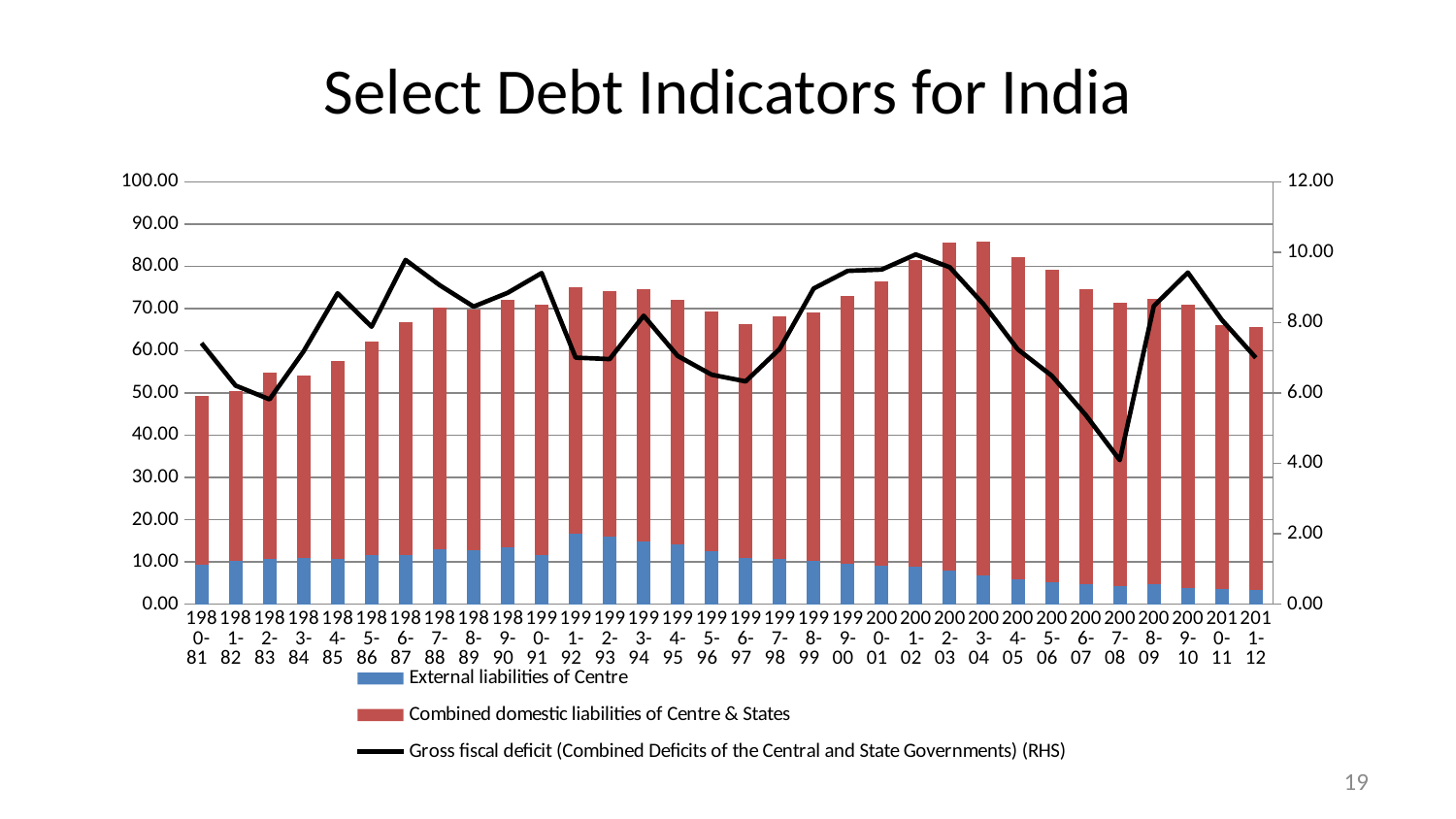
In which year does the Gross fiscal deficit line reach its lowest point? 2007-08 Which axis does the Gross fiscal deficit line use, according to the legend? The right-hand side (RHS) axis Is the External liabilities of Centre value for 1991-92 greater or less than 10.00? greater What is the title of the chart? Select Debt Indicators for India Which year has the lowest total stacked bar (external plus domestic liabilities)? 1980-81 Does the External liabilities of Centre series rise or fall from 1991-92 to 2011-12? fall Which is larger, the total stacked bar for 2003-04 or for 1980-81? 2003-04 How many fiscal years are plotted along the x axis? 32 Is the total stacked bar for 2003-04 greater or less than 80.00? greater Is the Gross fiscal deficit value for 2007-08 greater or less than 6.00 on the right-hand axis? less How many series does the legend list? 3 What kind of chart is shown on the slide? A stacked bar chart combined with a line chart